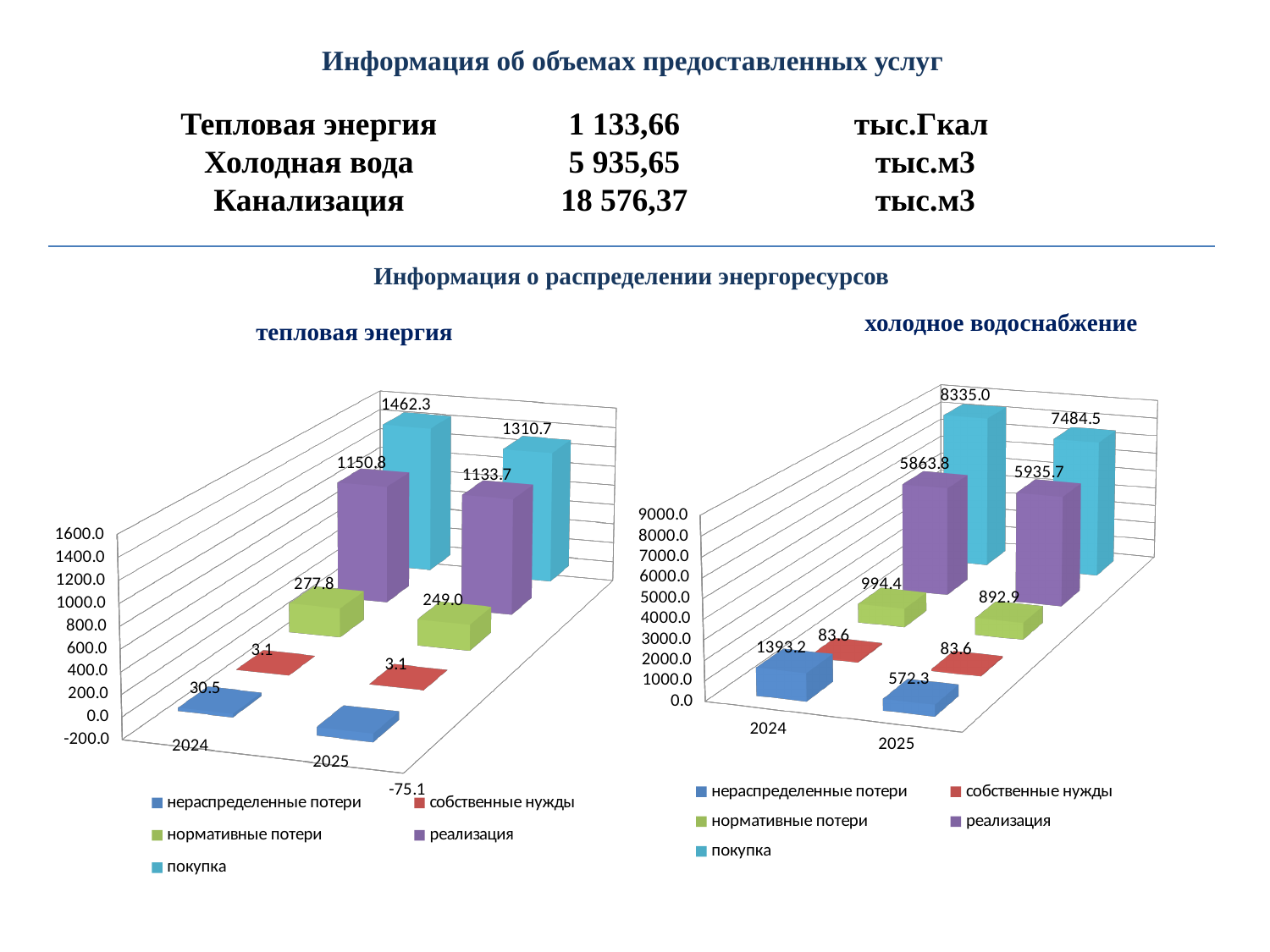
In the 'тепловая энергия' chart, what is the value of 'покупка' for 2024? 1462.3 In the 'тепловая энергия' chart, what is the value of 'нераспределенные потери' for 2025? -75.1 In the 'тепловая энергия' chart, which series has the highest value for 2024? покупка In the 'холодное водоснабжение' chart, which series has the lowest value for 2025? собственные нужды What type of chart is the 'тепловая энергия' chart? bar chart In the 'холодное водоснабжение' chart, what is the value of 'нормативные потери' for 2024? 994.4 In the 'тепловая энергия' chart, what is the value of 'реализация' for 2025? 1133.7 In the 'холодное водоснабжение' chart, what is the value of 'нераспределенные потери' for 2025? 572.3 In the 'тепловая энергия' chart, what is the difference between the 'покупка' values for 2024 and 2025? 151.6 How many series does the legend of the 'холодное водоснабжение' chart list? 5 In the 'холодное водоснабжение' chart, is the 'реализация' value larger for 2024 or 2025? 2025 In the 'холодное водоснабжение' chart, what is the value of 'покупка' for 2024? 8335.0